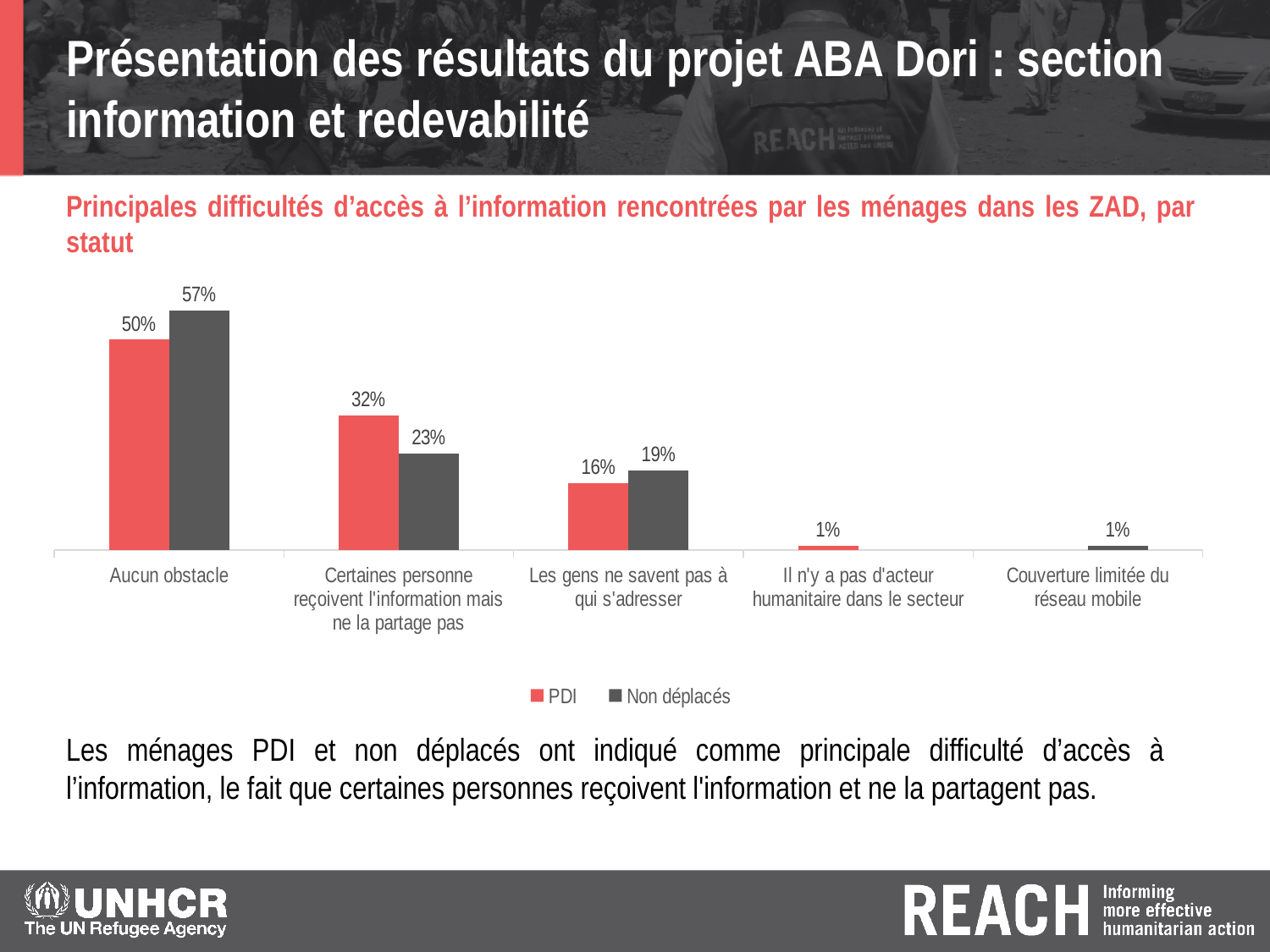
How many categories are shown on the x axis of the chart? 5 What is the value for PDI in the 'Certaines personne reçoivent l'information mais ne la partage pas' category? 32% What is the value for PDI in the 'Il n'y a pas d'acteur humanitaire dans le secteur' category? 1% In the 'Les gens ne savent pas à qui s'adresser' category, which series has the larger value, PDI or Non déplacés? Non déplacés Which category has the highest value for the Non déplacés series? Aucun obstacle What is the difference between the PDI and Non déplacés values in the 'Certaines personne reçoivent l'information mais ne la partage pas' category? 9% How many series does the chart legend list? 2 What type of chart is shown on the slide? Bar chart What is the value for Non déplacés in the 'Aucun obstacle' category? 57% What is the difference between the Non déplacés and PDI values in the 'Aucun obstacle' category? 7% What is the value for PDI in the 'Aucun obstacle' category? 50% What is the value for Non déplacés in the 'Les gens ne savent pas à qui s'adresser' category? 19%